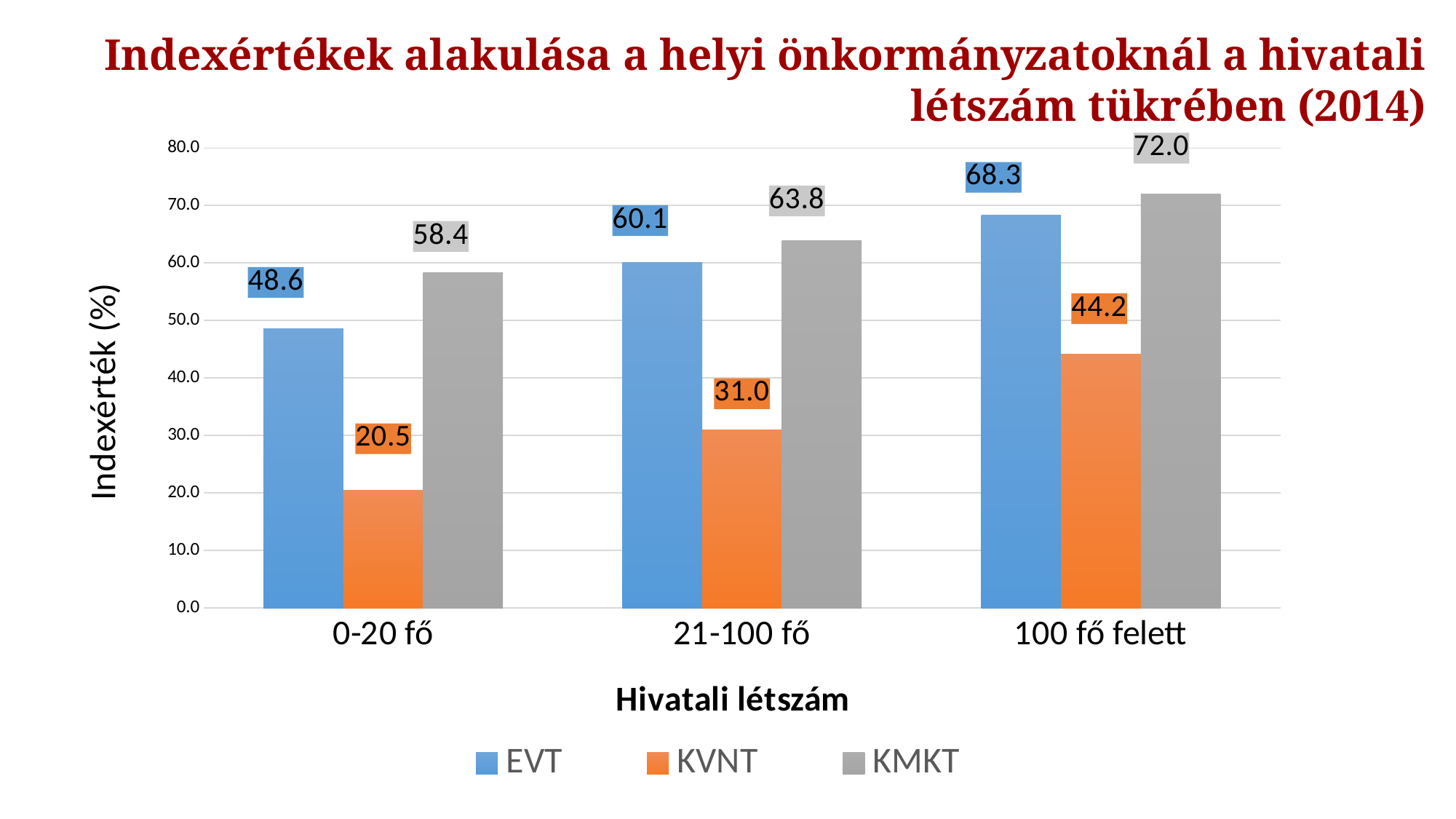
How many categories are shown on the x axis? 3 Which is larger for the 0-20 fő category: the EVT value or the KMKT value? KMKT Do the KMKT values rise or fall from 0-20 fő to 100 fő felett? rise What is the EVT value for the 0-20 fő category? 48.6 What is the difference between the KMKT and EVT values for the 21-100 fő category? 3.7 Which category has the lowest EVT value? 0-20 fő Is the KVNT value for the 100 fő felett category greater or less than 40.0? greater What is the KVNT value for the 21-100 fő category? 31.0 What is the KMKT value for the 100 fő felett category? 72.0 How many series does the legend list? 3 What kind of chart is shown on the slide? bar chart Which category has the highest KVNT value? 100 fő felett